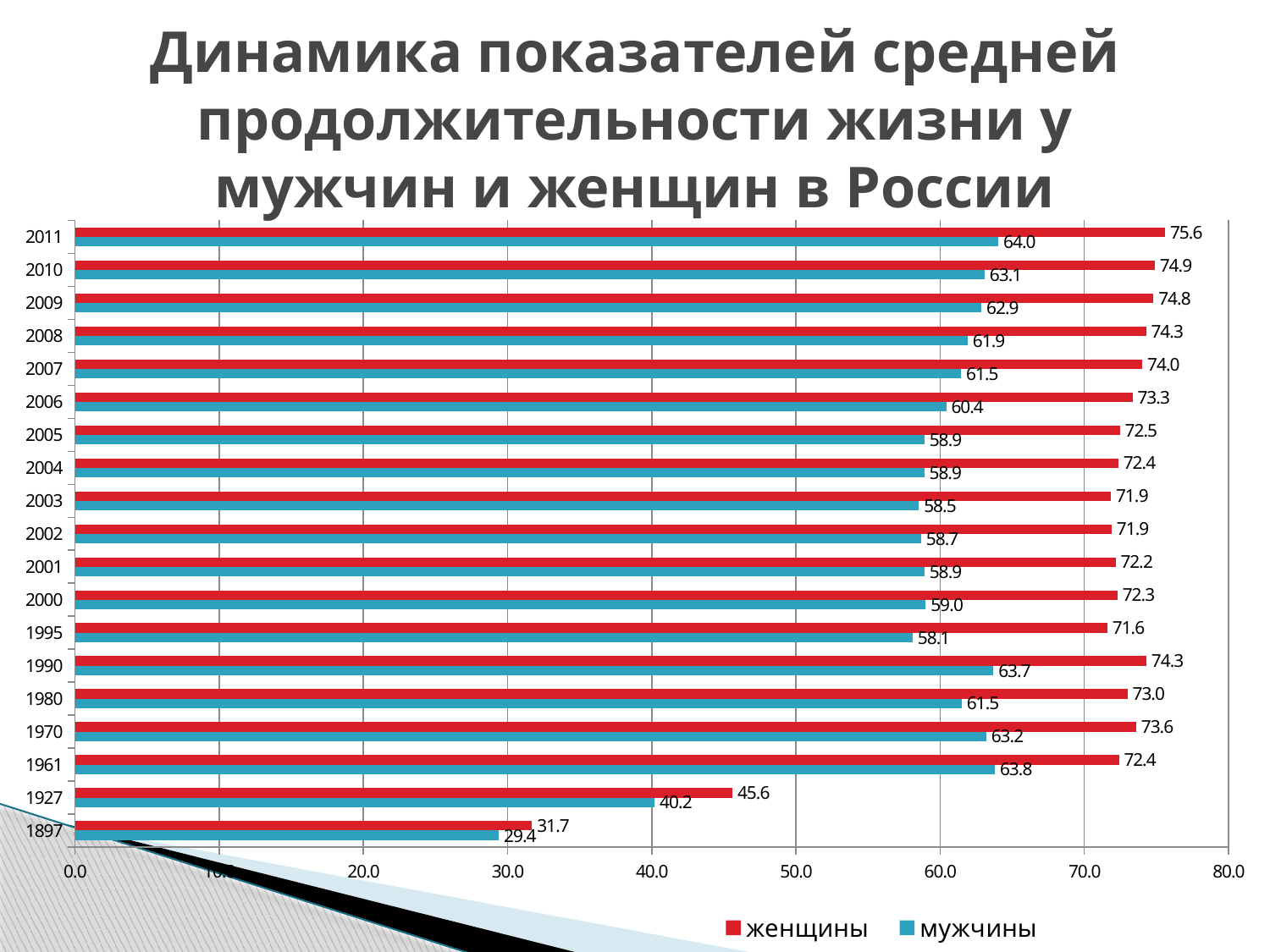
What is the value for женщины in 2011? 75.6 Which year has the highest value for мужчины? 2011 Which year has the lowest value for женщины? 1897 How many series does the legend list? 2 What kind of chart is shown on the slide? bar chart How many years are shown on the chart? 19 What is the value for мужчины in 1927? 40.2 What is the value for мужчины in 2006? 60.4 Which colour represents the series мужчины? blue What is the difference between the женщины and мужчины values in 2011? 11.6 Which is larger: the мужчины value in 1990 or the мужчины value in 1995? 1990 What is the difference between the женщины values in 1927 and 1897? 13.9